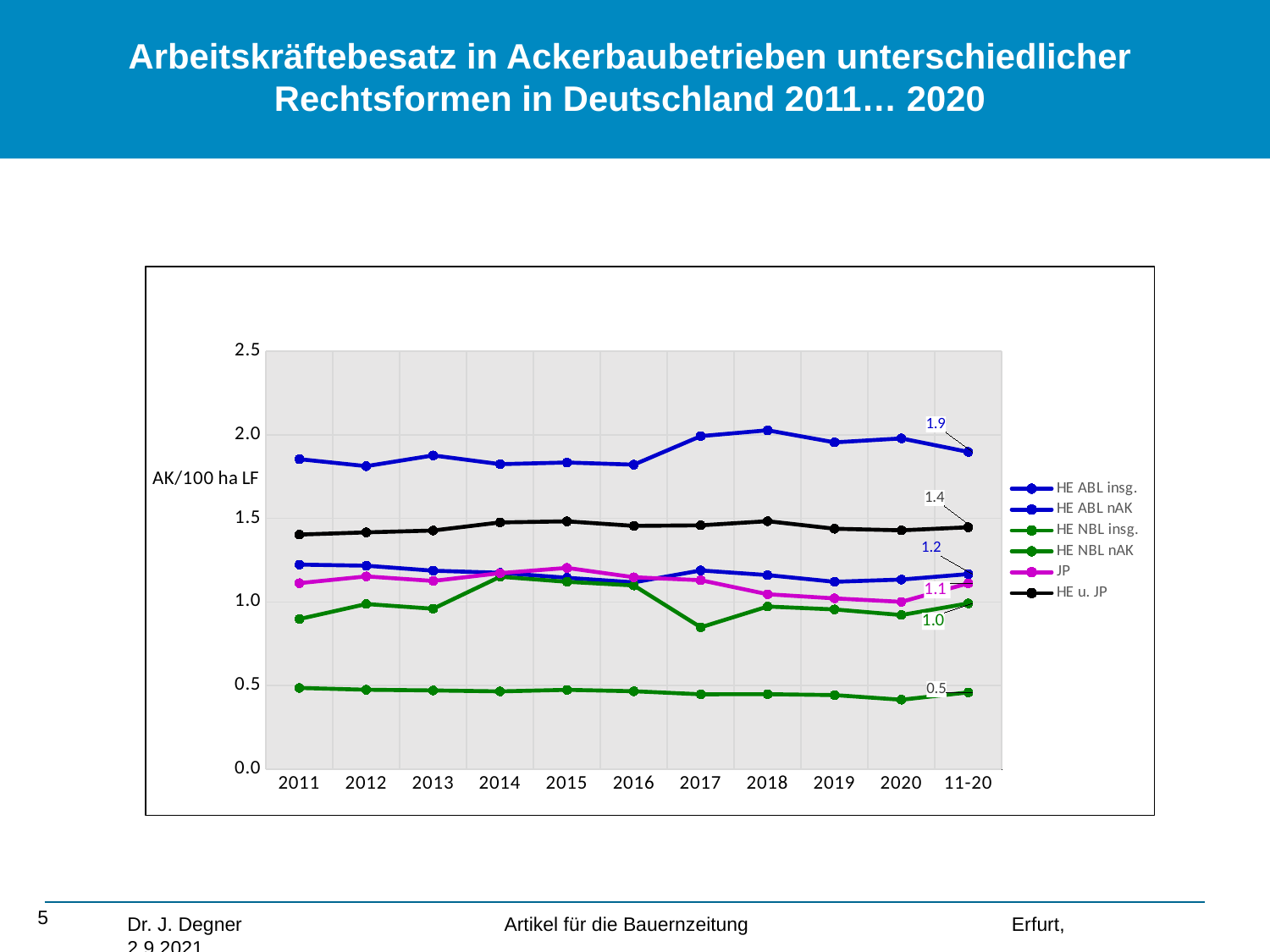
How many points are shown along the x axis? 11 What is the value for HE ABL insg. at 11-20? 1.9 What is the value for HE u. JP at 11-20? 1.4 Is the value for HE ABL insg. in 2011 greater or less than 2.0? less What kind of chart is shown on the slide? line chart What is the label on the y axis? AK/100 ha LF Which series has the highest value at 11-20? HE ABL insg. What is the difference between HE ABL insg. and HE NBL nAK at 11-20? 1.4 What is the value for HE NBL nAK at 11-20? 0.5 Which is larger at 11-20, HE u. JP or JP? HE u. JP How many series does the legend list? 6 Which series has the lowest value at 11-20? HE NBL nAK